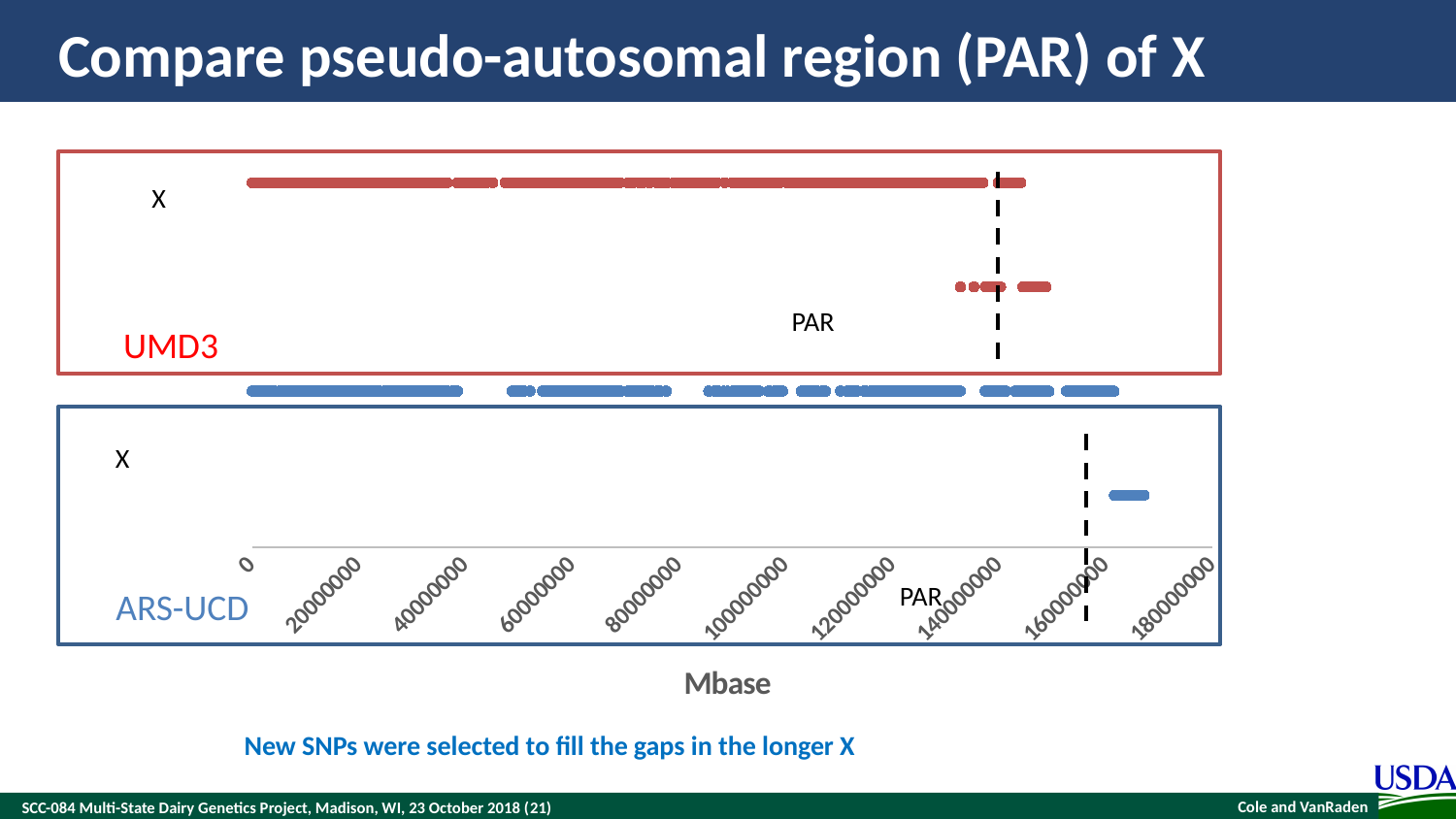
What kind of chart is used to show the SNP positions on chromosome X? scatter chart Which assembly is plotted in red in the chart? UMD3 What is the largest tick label shown on the x axis? 180000000 Which assembly's X chromosome extends further along the x axis, UMD3 or ARS-UCD? ARS-UCD How many tick labels are shown on the x axis of the chart? 10 Which assembly, UMD3 or ARS-UCD, has its PAR boundary further along the x axis? ARS-UCD What is the title of the x axis of the chart? Mbase Is the position of the ARS-UCD PAR dashed line greater or less than 140000000? greater Is the far end of the red UMD3 series greater or less than 160000000? less Is the position of the UMD3 PAR dashed line greater or less than 160000000? less